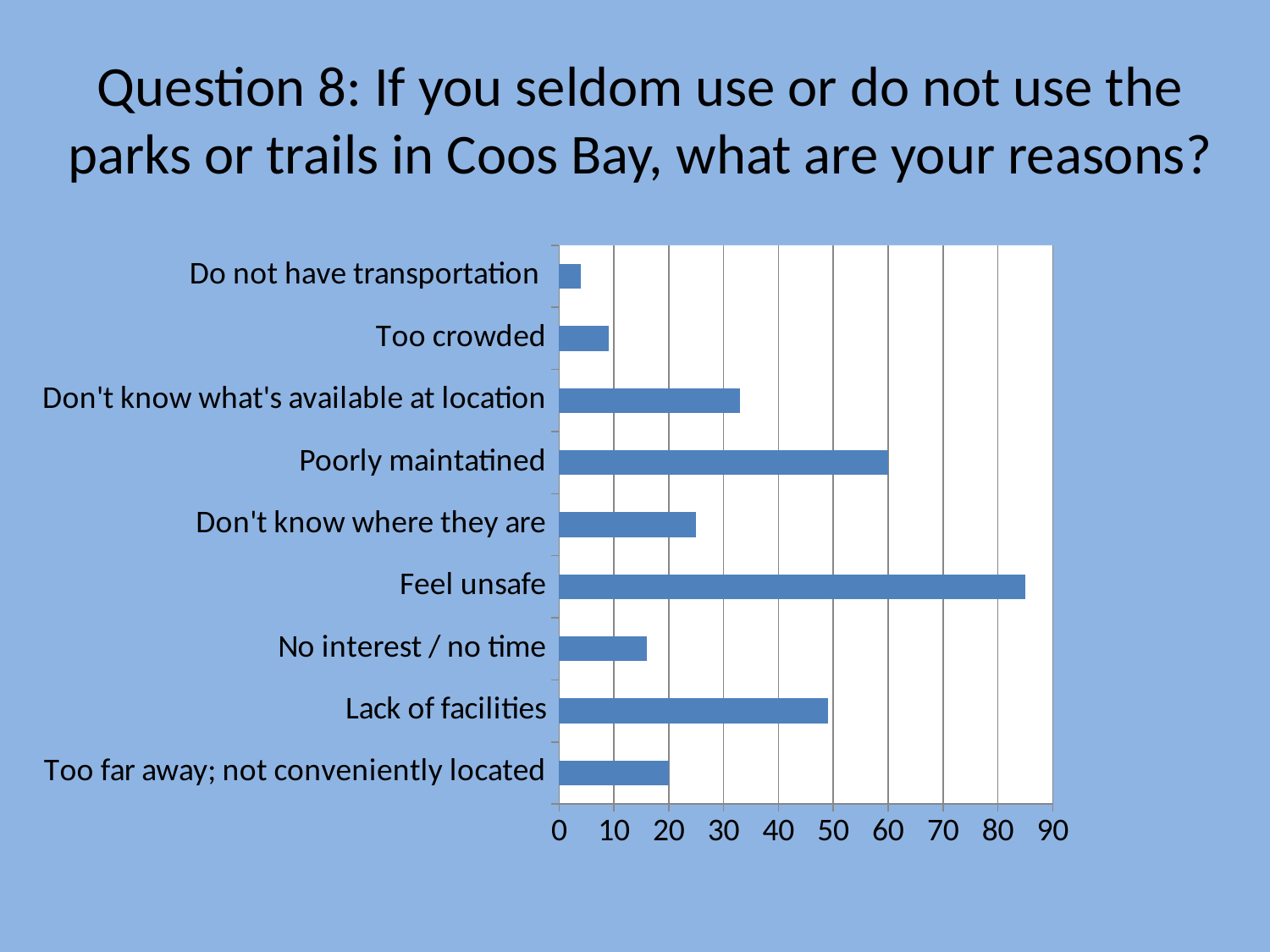
What type of chart is shown on the slide? bar chart Is the value for Feel unsafe greater or less than 80? greater What is the title of the slide containing the chart? Question 8: If you seldom use or do not use the parks or trails in Coos Bay, what are your reasons? Which reason has the lowest value in the chart? Do not have transportation Is the value for Don't know where they are greater or less than 20? greater Which reason has the highest value in the chart? Feel unsafe Which is larger: the value for Lack of facilities or the value for Don't know what's available at location? Lack of facilities Which is larger: the value for Poorly maintatined or the value for Feel unsafe? Feel unsafe How many reasons (categories) are plotted in the chart? 9 Is the value for No interest / no time greater or less than 20? less